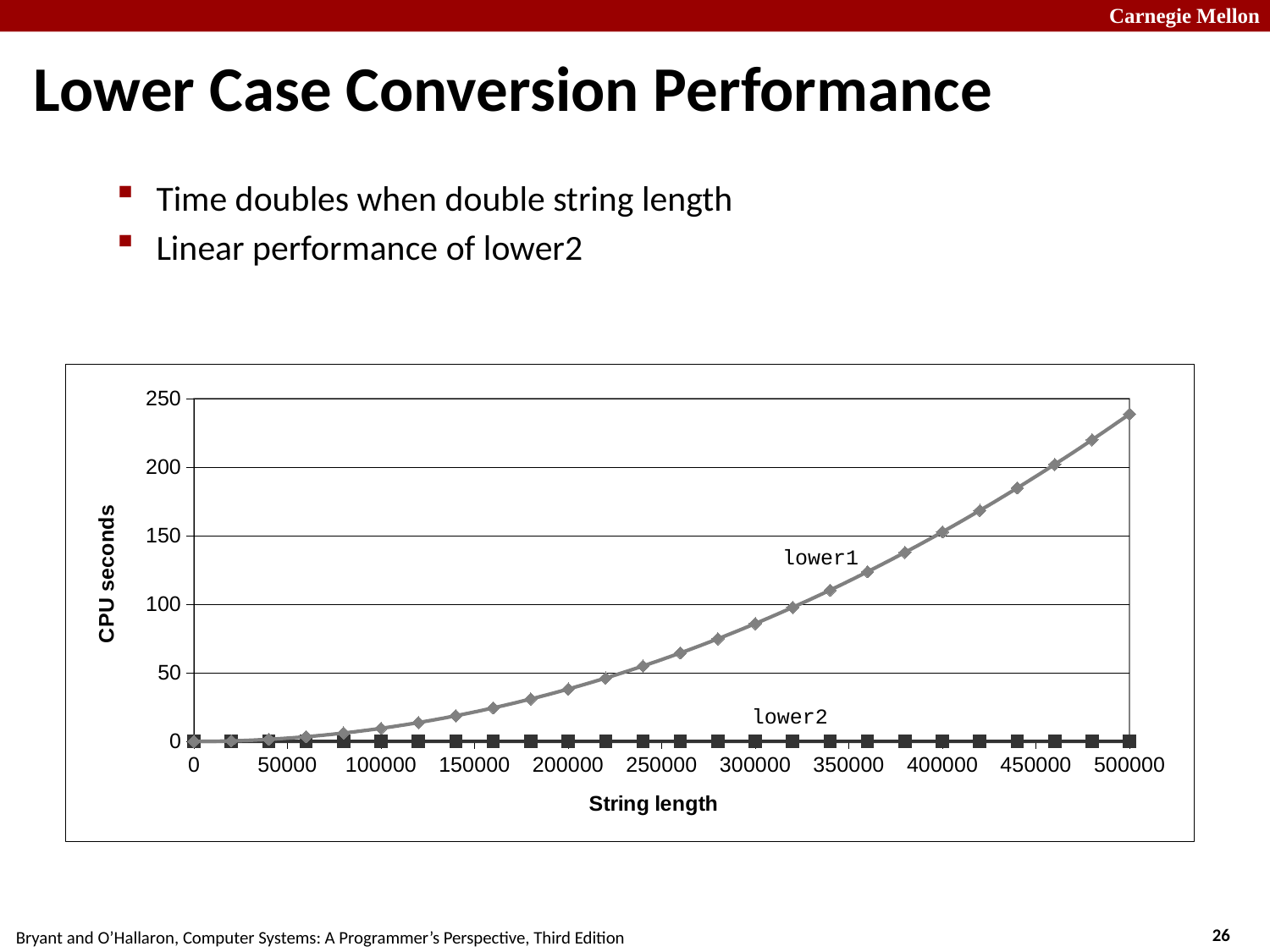
How many data series are plotted on the chart? 2 What is the label of the y axis? CPU seconds What kind of chart is shown on the slide? line chart What are the names of the two series plotted on the chart? lower1 and lower2 Is the value for lower1 at a string length of 500000 greater or less than 200? greater Which series stays lowest across all string lengths? lower2 Is the value for lower1 at a string length of 300000 greater or less than 100? less Which series has the higher CPU seconds at a string length of 500000? lower1 Is the value for lower1 at a string length of 200000 greater or less than 50? less Do the values for lower1 rise or fall as string length increases? rise